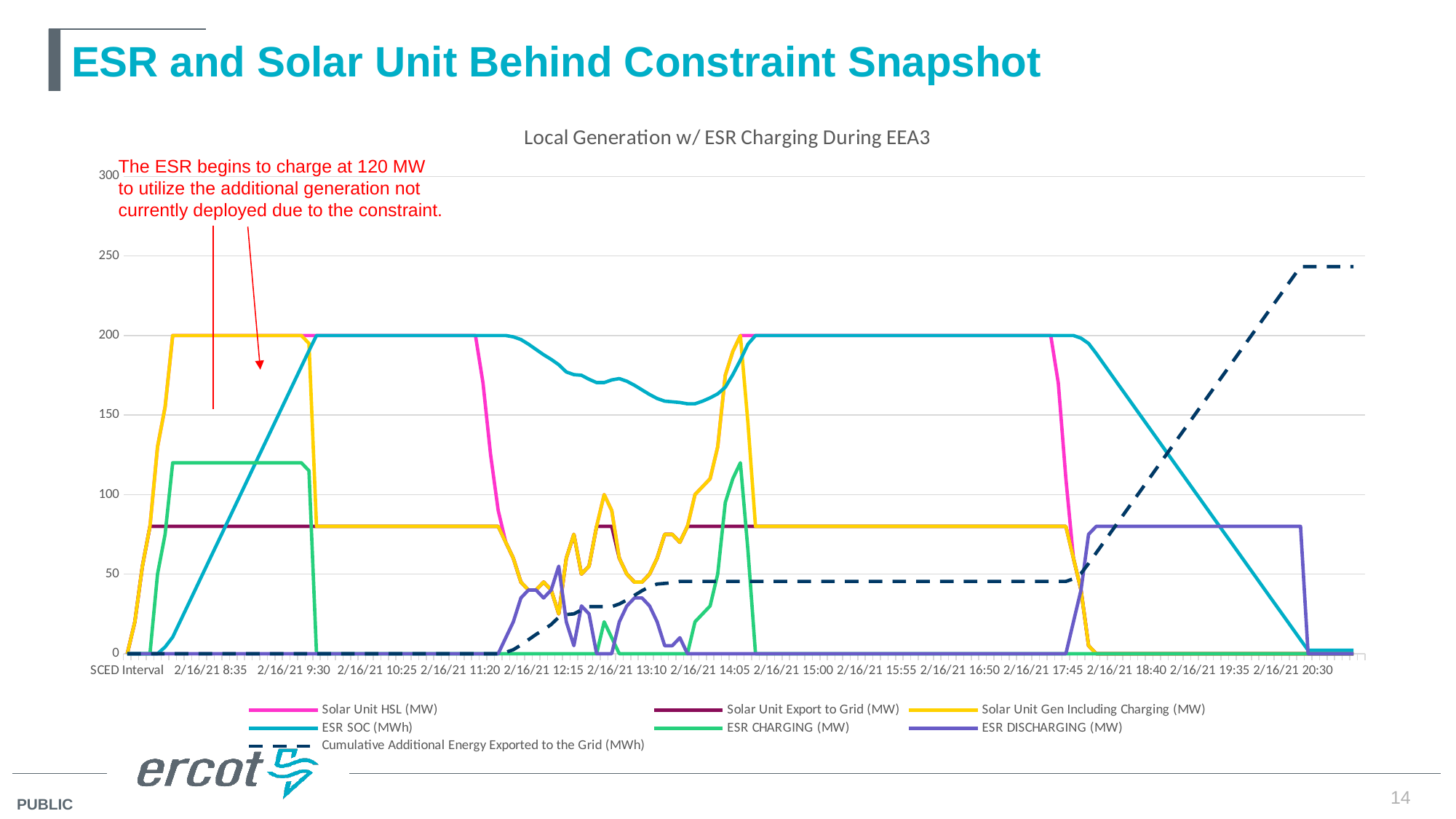
Is the value of Solar Unit Export to Grid (MW) at 2/16/21 10:25 greater or less than 100? less Is the value of ESR SOC (MWh) at 2/16/21 15:00 greater or less than 150? greater What kind of chart is shown on the slide? Line chart Is the value of ESR DISCHARGING (MW) at 2/16/21 19:35 greater or less than 50? greater Does Cumulative Additional Energy Exported to the Grid (MWh) rise or fall between 2/16/21 17:45 and 2/16/21 19:35? rise According to the annotation, at what level does the ESR begin to charge? 120 MW What is the plateau value of Solar Unit HSL (MW) between 2/16/21 8:35 and 2/16/21 11:20? 200 Does ESR SOC (MWh) rise or fall between 2/16/21 18:40 and 2/16/21 20:30? fall Which series is drawn as a dashed line? Cumulative Additional Energy Exported to the Grid (MWh) How many series does the legend list? 7 What is the title of the chart? Local Generation w/ ESR Charging During EEA3